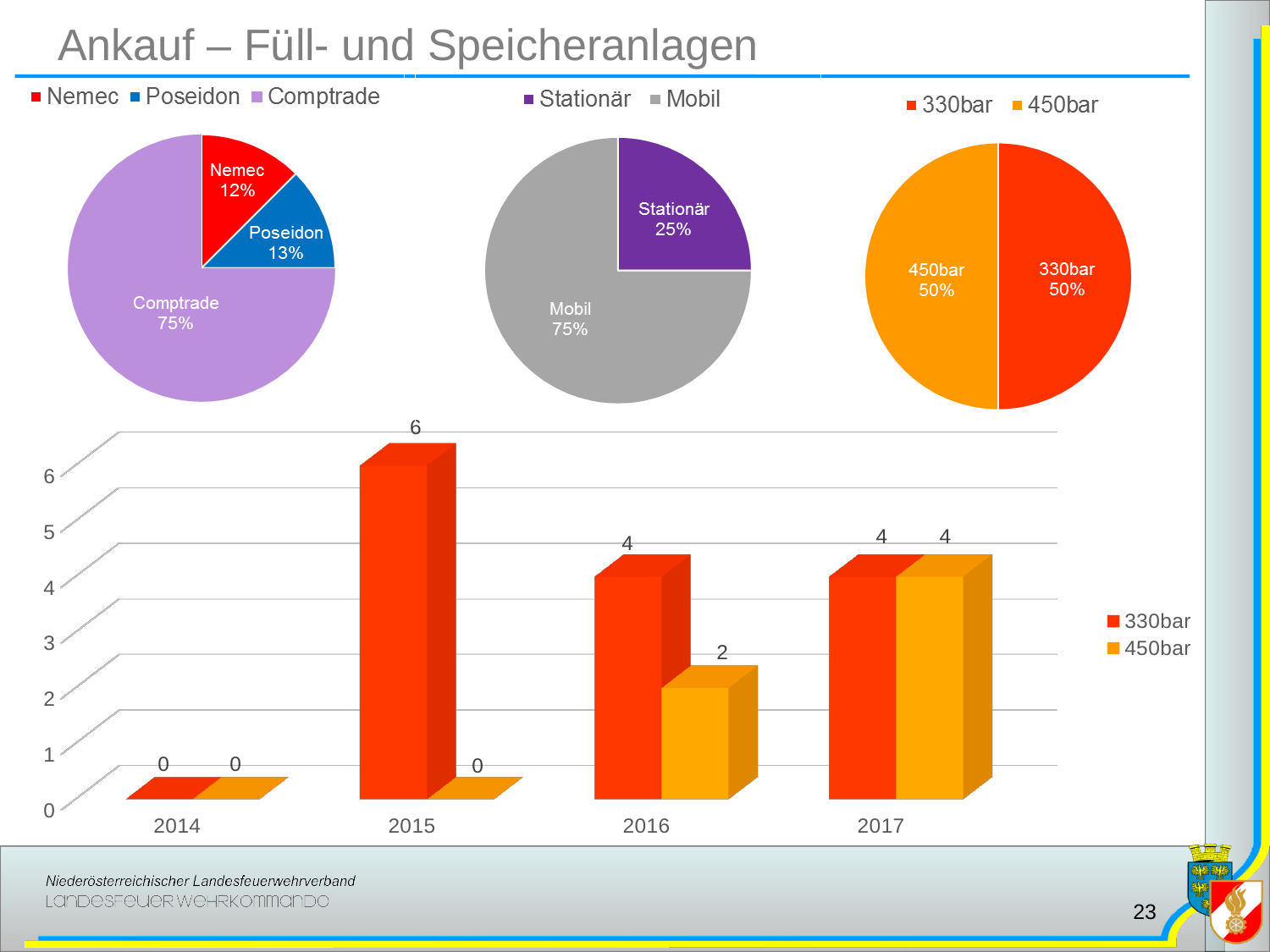
In the top-middle pie chart, which slice is larger, Mobil or Stationär? Mobil In the bottom bar chart, which year has the highest value for 330bar? 2015 In the bottom bar chart, what is the value for 450bar in 2016? 2 In the top-left pie chart, what share does Poseidon have? 13% In the bottom bar chart, what is the value for 330bar in 2015? 6 In the top-left pie chart, which slice is the smallest? Nemec How many series does the legend of the bottom bar chart list? 2 In the bottom bar chart, what is the difference between 330bar and 450bar in 2016? 2 In the top-middle pie chart, what share does Stationär have? 25% What kind of chart is shown at the bottom of the slide? Bar chart In the top-right pie chart, what share does 450bar have? 50%